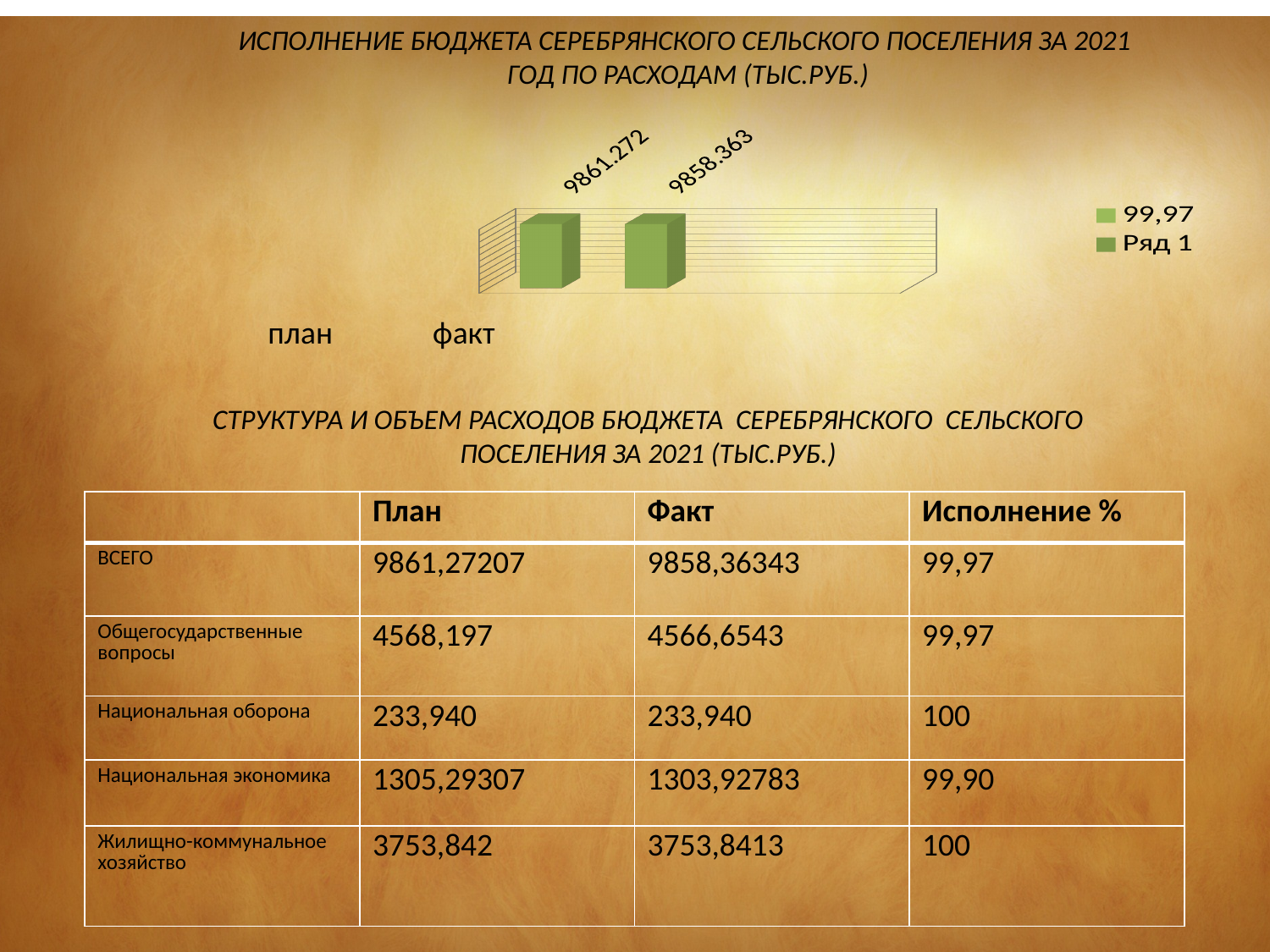
Which is larger in the chart, план or факт? план What is the difference between the план and факт values in the chart? 2.909 What kind of chart is shown on the slide? bar chart What colour are the bars in the chart? green What is the value of the план bar in the chart? 9861.272 How many bars are plotted in the chart? 2 What are the two entries shown in the chart legend? 99,97 and Ряд 1 What is the value of the факт bar in the chart? 9858.363 How many entries does the chart legend list? 2